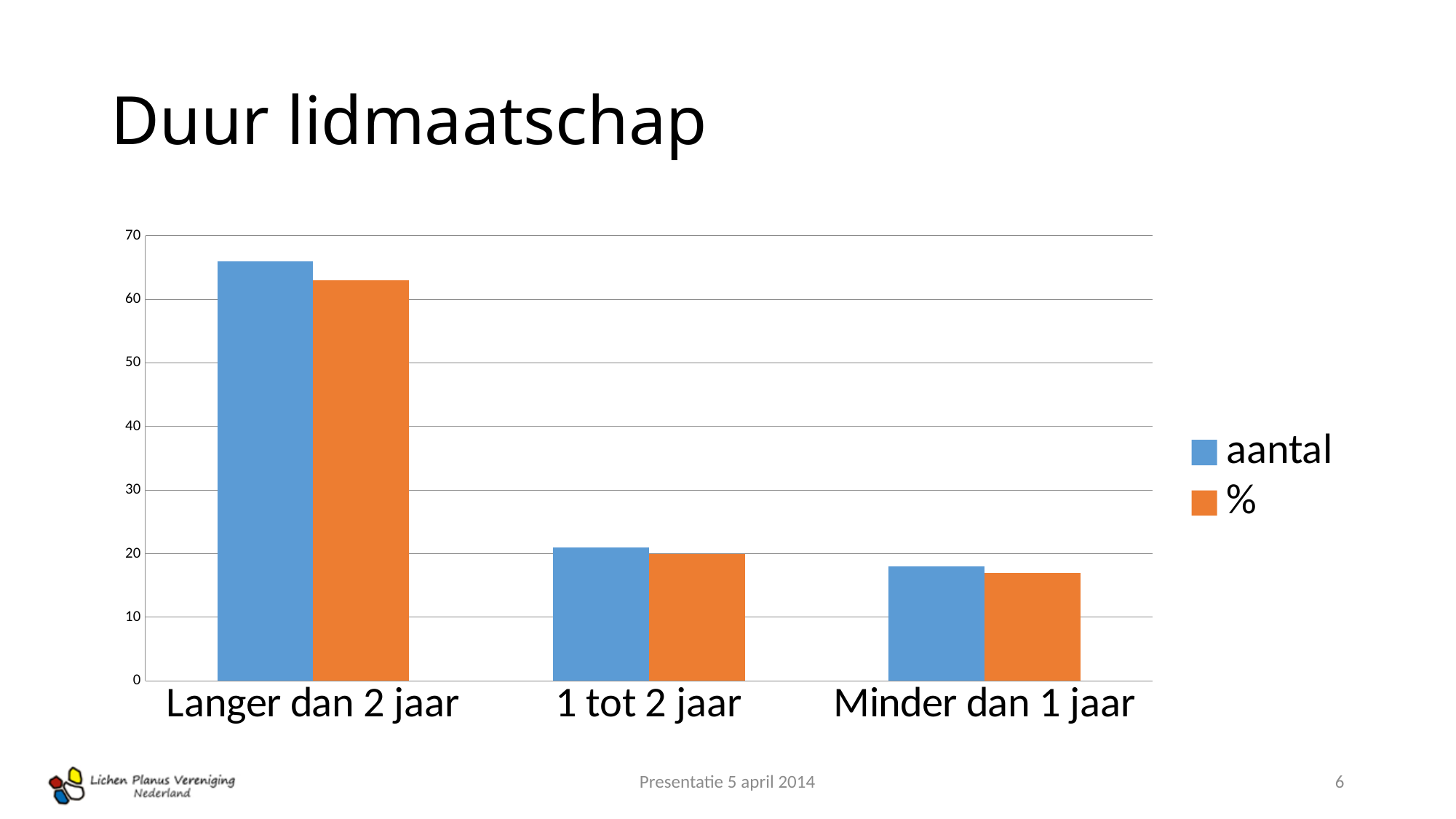
What kind of chart is shown on the slide? bar chart How many series does the legend list? 2 Which is larger: the aantal value for 1 tot 2 jaar or the aantal value for Minder dan 1 jaar? 1 tot 2 jaar How many categories are shown on the x axis? 3 Is the % value for Minder dan 1 jaar greater or less than 10? greater Which colour represents the % series in the legend? orange Do the aantal values rise or fall from left to right along the x axis? fall Which category has the highest value for the aantal series? Langer dan 2 jaar Is the aantal value for 1 tot 2 jaar greater or less than 30? less What is the title of the slide containing the chart? Duur lidmaatschap Is the aantal value for Langer dan 2 jaar greater or less than 60? greater Which category has the lowest value for the % series? Minder dan 1 jaar